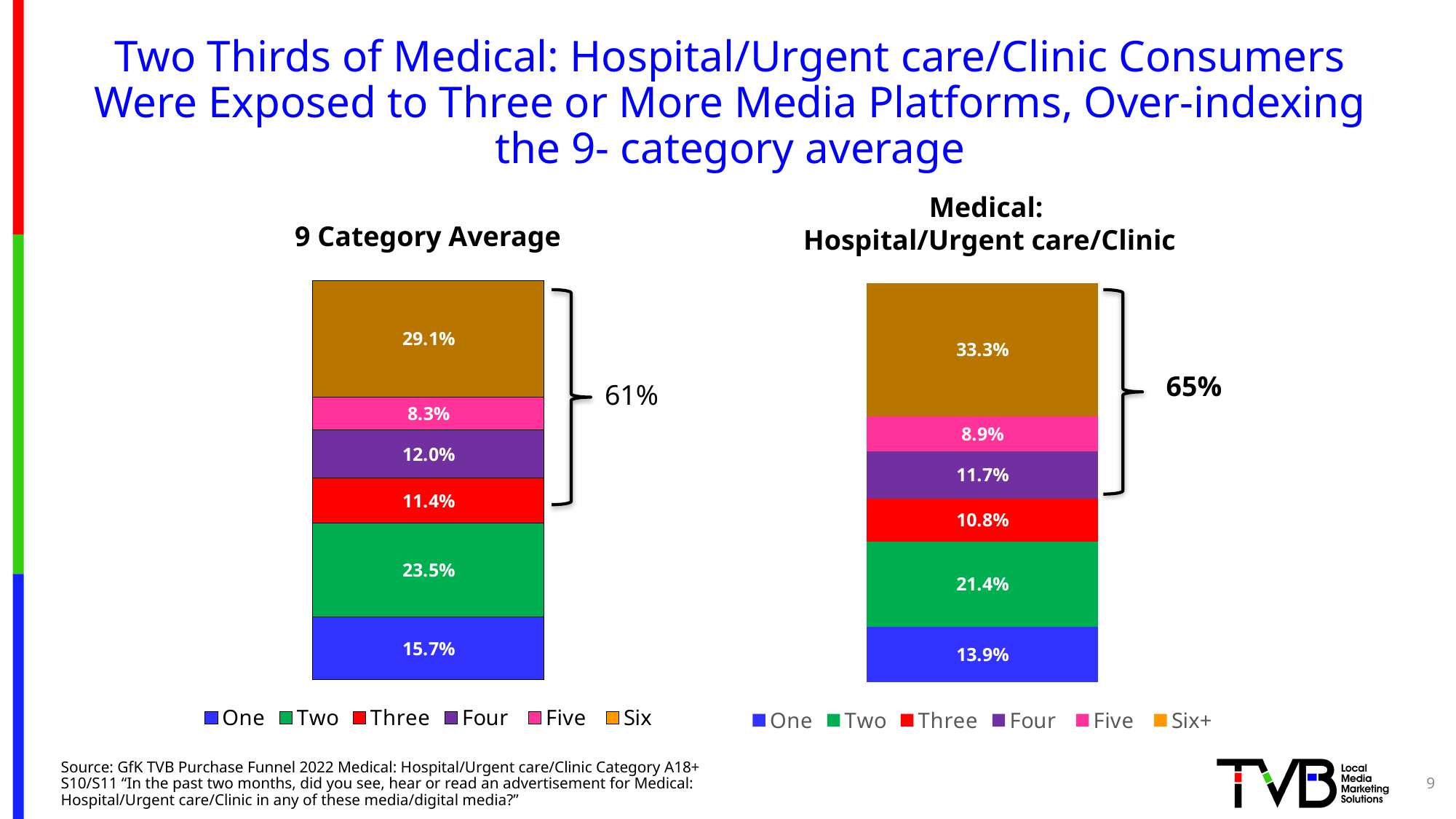
In the Medical: Hospital/Urgent care/Clinic chart, what is the value for the One segment? 13.9% In the 9 Category Average chart, what is the difference between the Two segment and the Three segment? 12.1% In the Medical: Hospital/Urgent care/Clinic chart, which segment has the smallest value? Five Which is larger: the Six+ segment in the Medical: Hospital/Urgent care/Clinic chart or the Six segment in the 9 Category Average chart? Six+ in Medical: Hospital/Urgent care/Clinic In the Medical: Hospital/Urgent care/Clinic chart, what is the difference between the Four segment and the Three segment? 0.9% What percentage is shown next to the bracket on the Medical: Hospital/Urgent care/Clinic chart? 65% How many series does the legend of the 9 Category Average chart list? 6 What is the title of the chart on the left side of the slide? 9 Category Average In the Medical: Hospital/Urgent care/Clinic chart, what is the value for the Two segment? 21.4% In the 9 Category Average chart, which segment has the largest value? Six What kind of chart is the Medical: Hospital/Urgent care/Clinic chart? Stacked bar chart In the 9 Category Average chart, what is the value for the Six segment? 29.1%